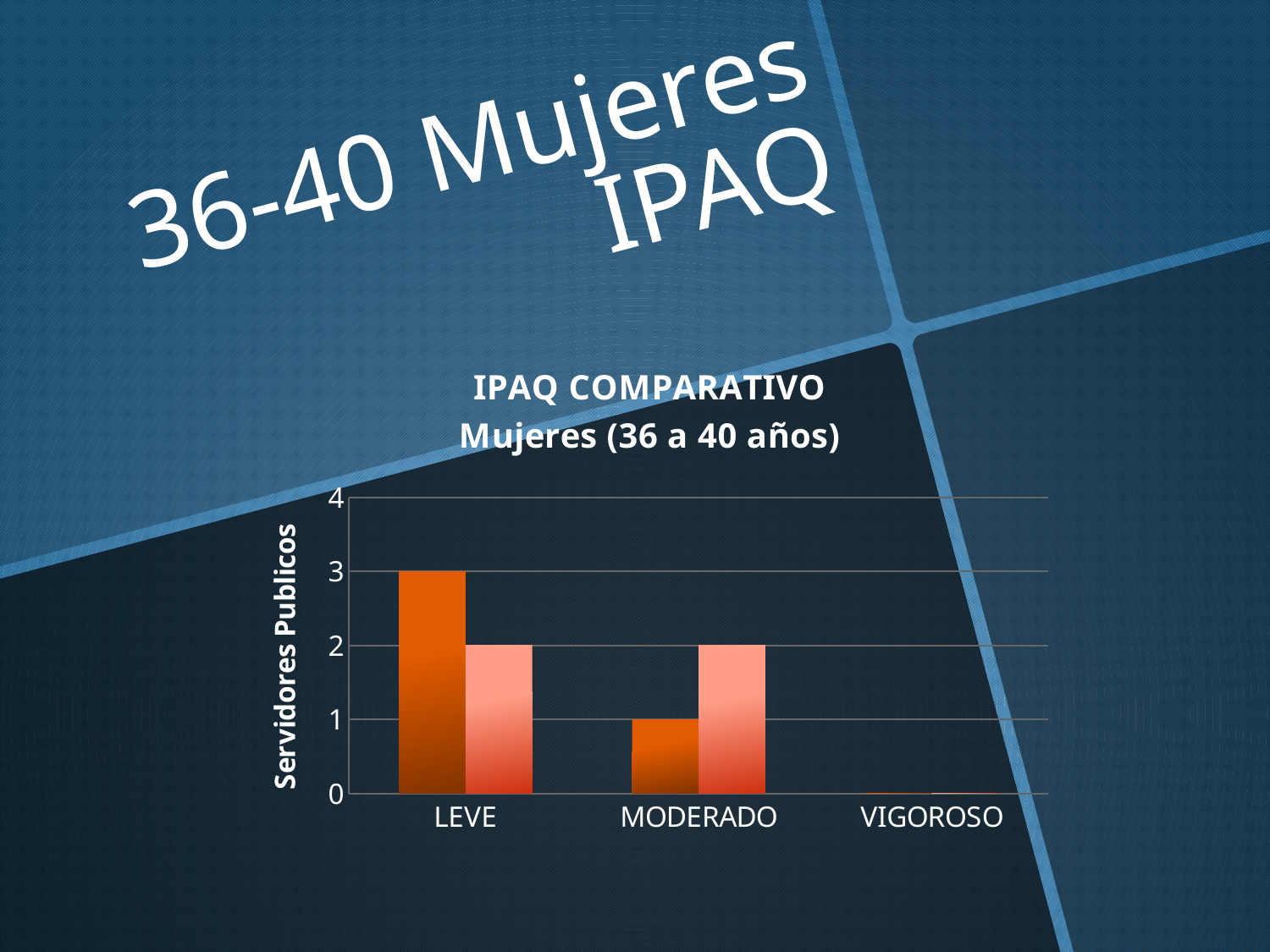
What is the value of the darker orange bar for LEVE? 3 What is the title of the chart? IPAQ COMPARATIVO Mujeres (36 a 40 años) For MODERADO, which is larger: the darker orange bar or the lighter orange bar? the lighter orange bar What is the label of the vertical axis of the chart? Servidores Publicos What is the value of the darker orange bar for MODERADO? 1 Which category has the tallest bar in the chart? LEVE What is the value of the lighter orange bar for MODERADO? 2 What kind of chart is shown on the slide? bar chart Which category has the lowest values in the chart? VIGOROSO What is the difference between the darker orange bar and the lighter orange bar for LEVE? 1 How many categories are shown on the x axis of the chart? 3 What is the value of the lighter orange bar for LEVE? 2